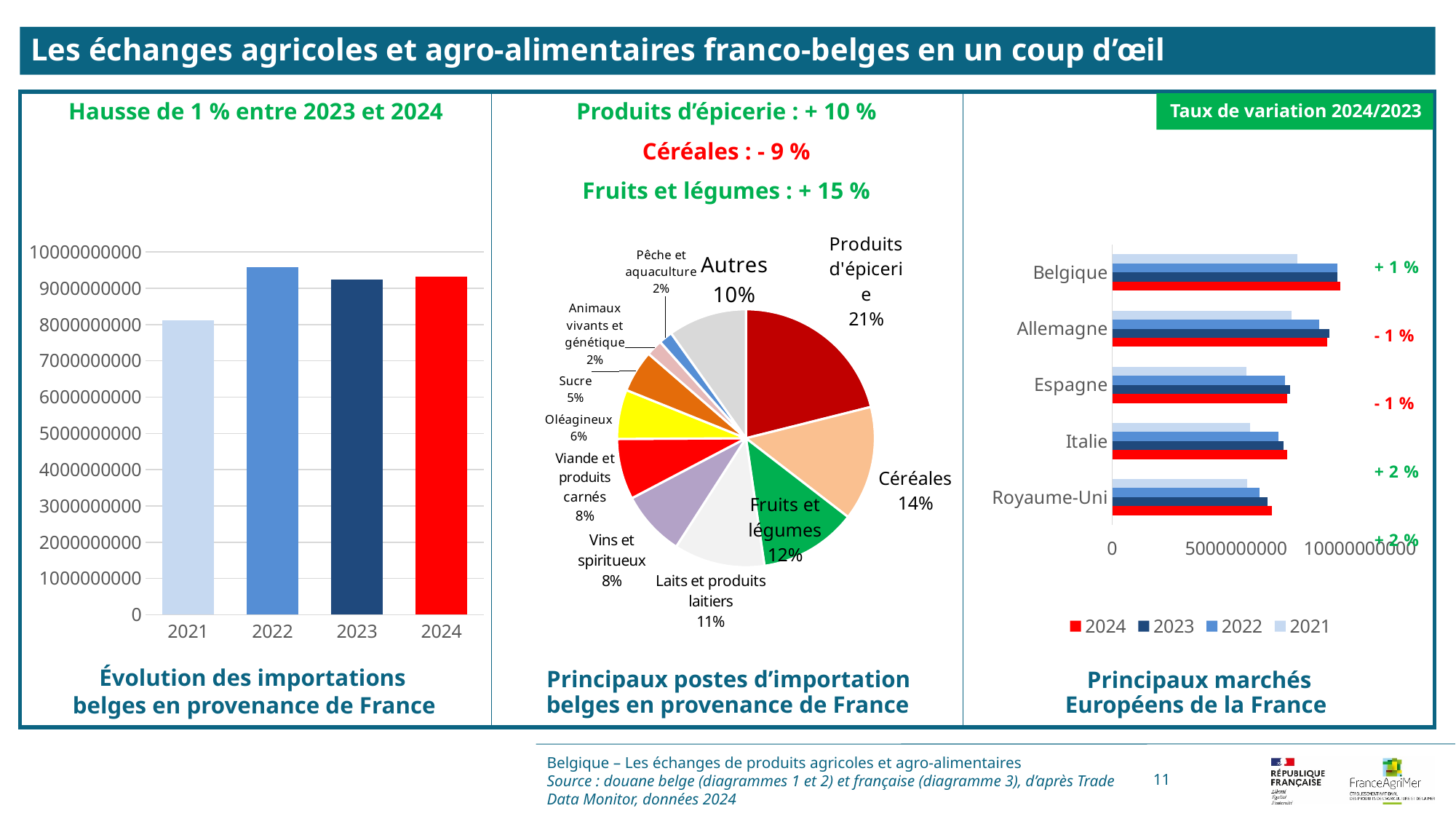
On the right chart 'Principaux marchés Européens de la France', which country has the highest 2024 value? Belgique On the left chart 'Évolution des importations belges en provenance de France', what kind of chart is shown? bar chart On the left chart 'Évolution des importations belges en provenance de France', which year has the lowest value? 2021 On the middle pie chart 'Principaux postes d'importation belges en provenance de France', what is the difference in percentage points between Produits d'épicerie and Fruits et légumes? 9 On the middle pie chart 'Principaux postes d'importation belges en provenance de France', what share does Céréales have? 14% On the right chart 'Principaux marchés Européens de la France', is the 2024 value for Belgique greater or less than 5000000000? greater On the middle pie chart 'Principaux postes d'importation belges en provenance de France', how many slices does the pie have? 11 On the left chart 'Évolution des importations belges en provenance de France', is the value for 2021 greater or less than 9000000000? less On the middle pie chart 'Principaux postes d'importation belges en provenance de France', which category has the largest share? Produits d'épicerie On the left chart 'Évolution des importations belges en provenance de France', which year has the highest value? 2022 On the right chart 'Principaux marchés Européens de la France', how many series does the legend list? 4 On the left chart 'Évolution des importations belges en provenance de France', is the value for 2022 greater or less than 9000000000? greater